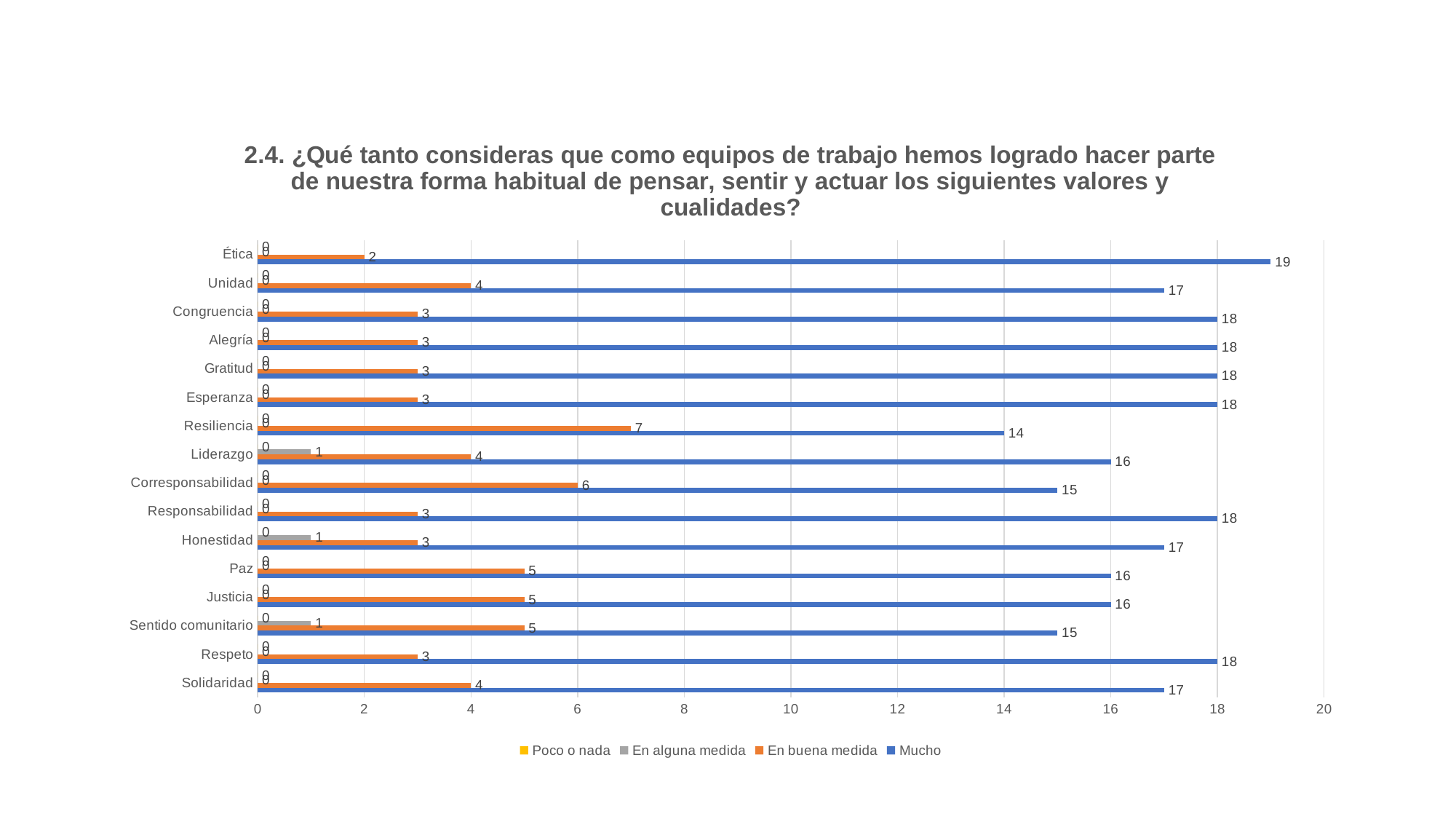
How many series does the legend list? 4 What is the 'Mucho' value for Sentido comunitario? 15 What is the difference between the 'Mucho' values for Ética and Resiliencia? 5 What is the 'En buena medida' value for Resiliencia? 7 How many categories (values/qualities) are plotted on the chart? 16 Which category has the lowest 'Mucho' value? Resiliencia Which series in the legend is shown in blue? Mucho Which is larger: the 'En buena medida' value for Corresponsabilidad or for Paz? Corresponsabilidad What is the 'En alguna medida' value for Liderazgo? 1 What type of chart is shown on the slide? bar chart What is the 'Mucho' value for Ética? 19 Which category has the highest 'Mucho' value? Ética